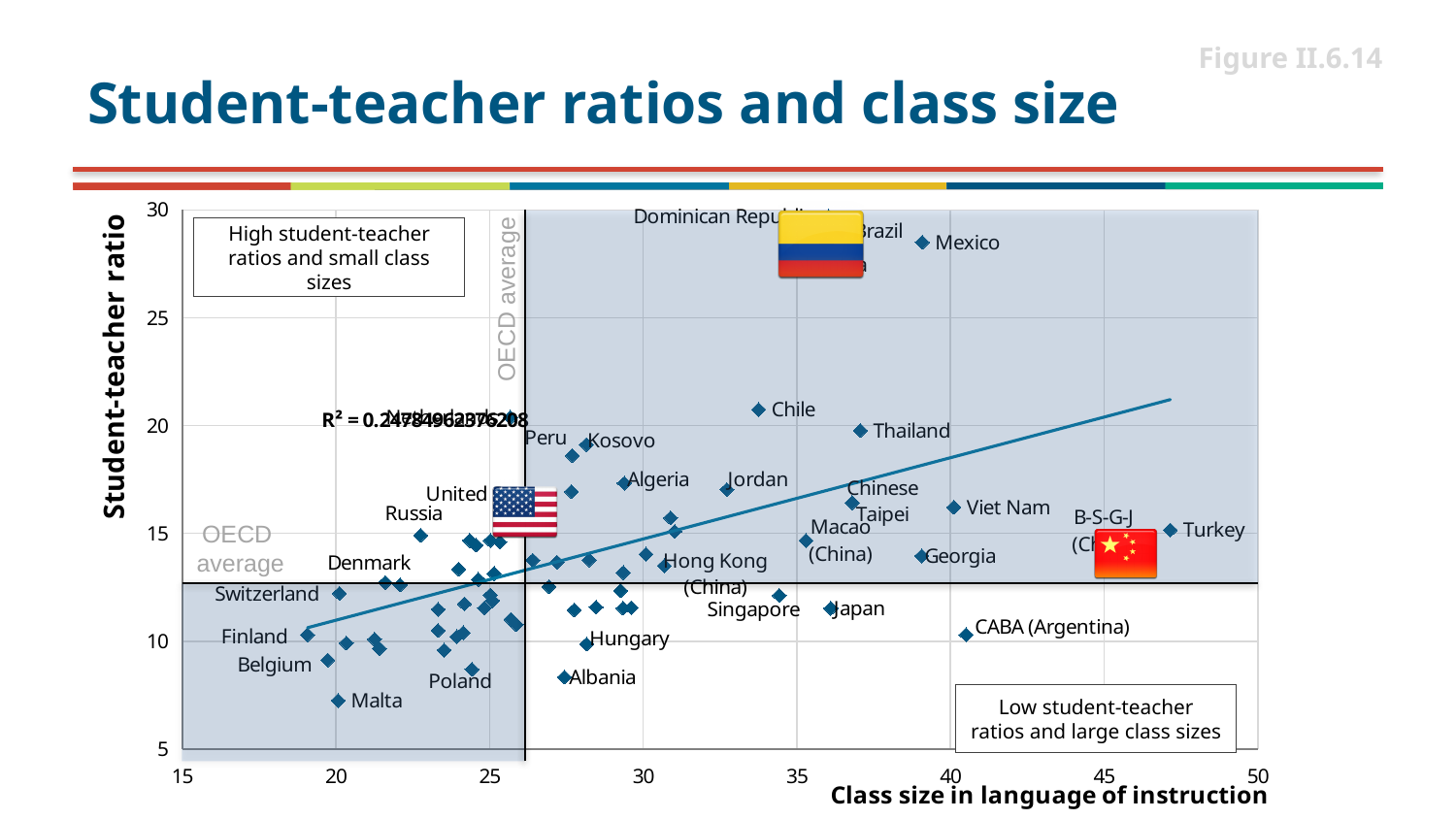
What kind of chart is shown on the slide? scatter chart Is the student-teacher ratio for Albania greater or less than 10? less Is the student-teacher ratio for CABA (Argentina) greater or less than 15? less Is the class size for Turkey greater or less than 45? greater Which has the larger class size, Turkey or Viet Nam? Turkey Which has the higher student-teacher ratio, Mexico or Japan? Mexico Does the fitted trend line rise or fall as class size increases? rises Which country has the lowest student-teacher ratio? Malta Which country has the largest class size in language of instruction? Turkey